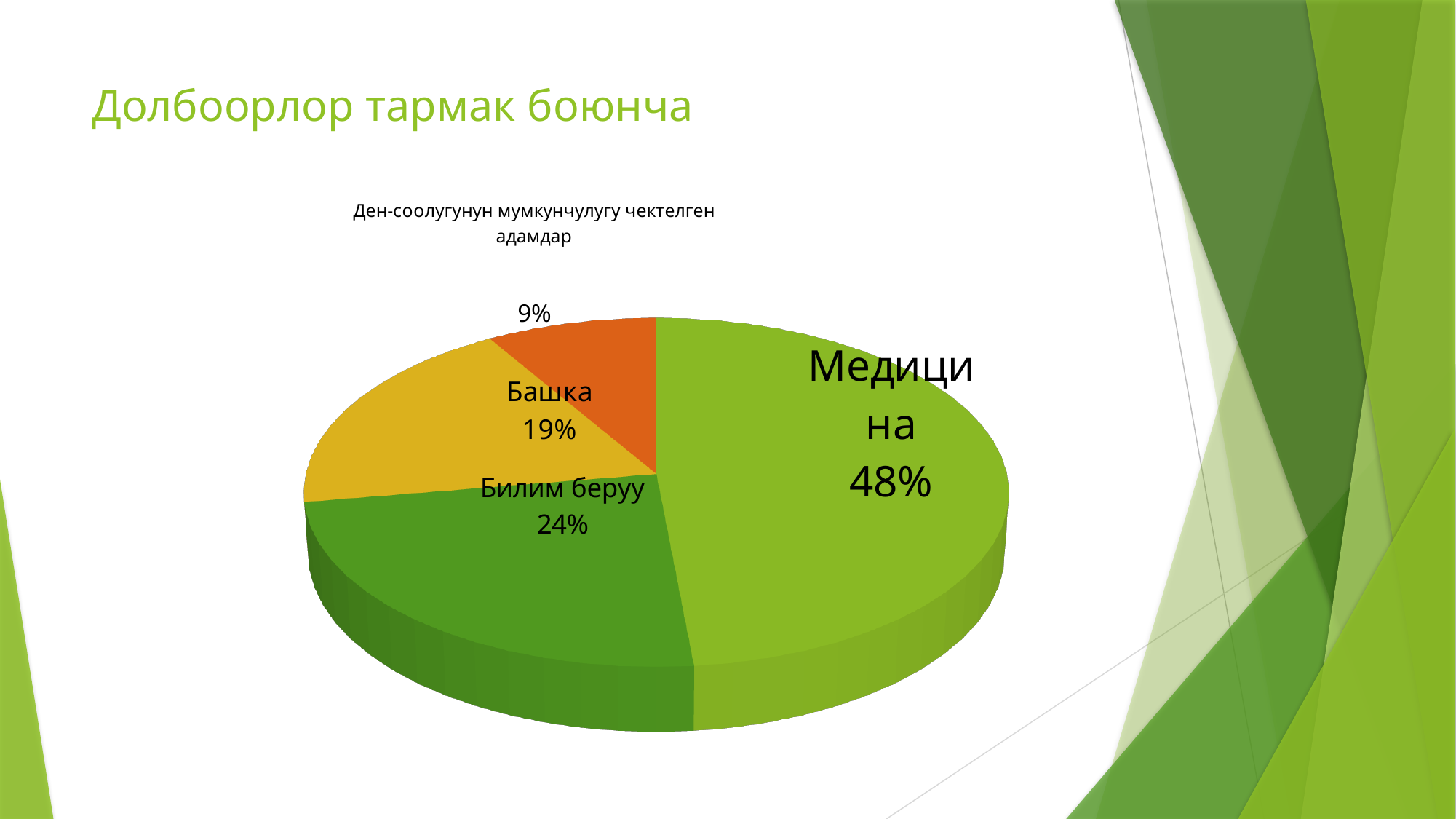
What percentage is shown for the orange slice of the pie? 9% What percentage does the Медицина slice represent? 48% How many slices does the pie chart have? 4 What kind of chart is shown on the slide? pie chart Which is larger, the Башка slice or the Билим беруу slice? Билим беруу What percentage does the Башка slice represent? 19% What colour is the Медицина slice? green What percentage does the Билим беруу slice represent? 24% Which category has the largest share of the pie? Медицина What is the difference in percentage points between Билим беруу and Башка? 5 What is the difference in percentage points between Медицина and Билим беруу? 24 What is the smallest percentage shown on the pie chart? 9%